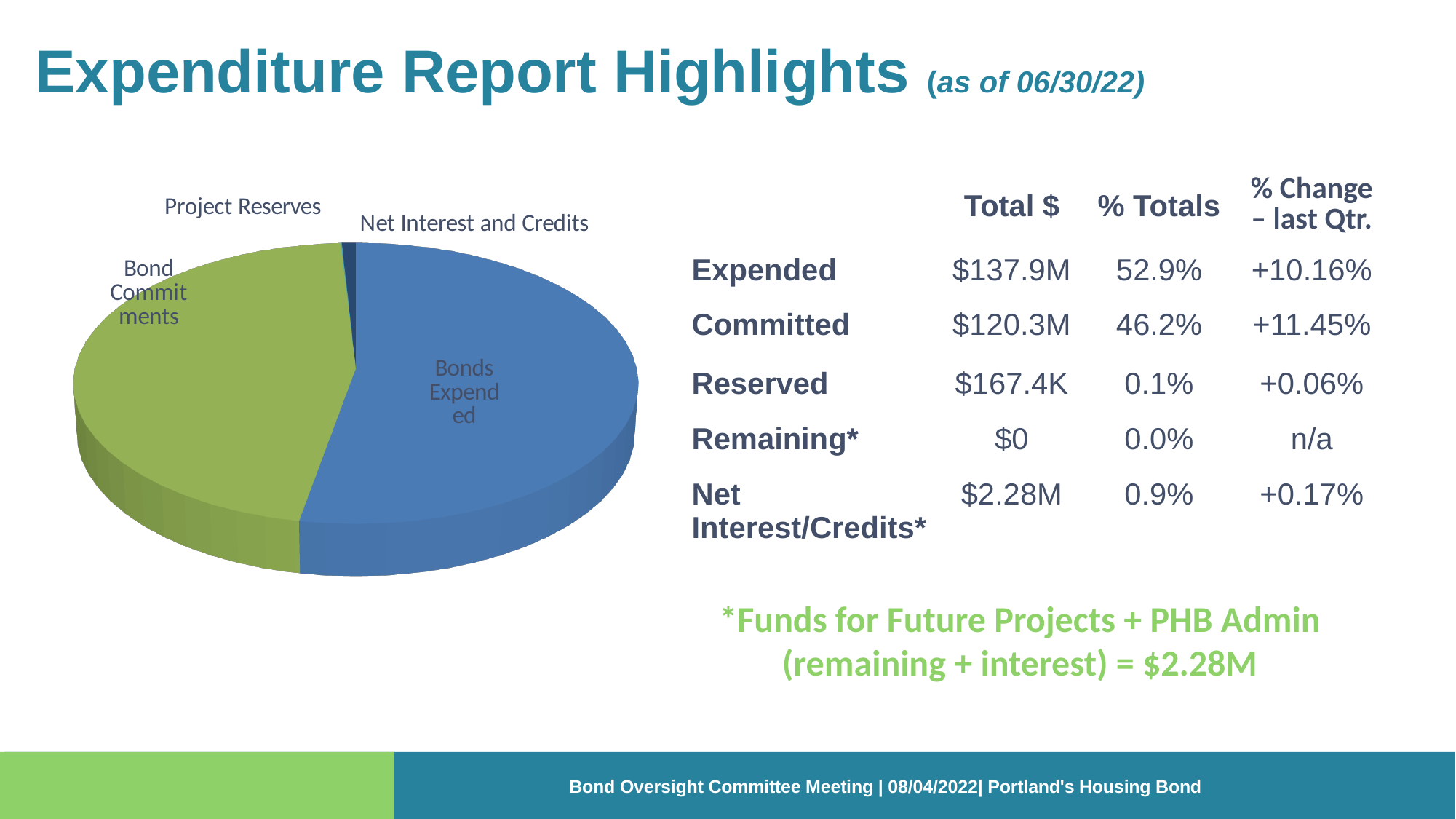
Which slice of the pie chart is the largest? Bonds Expended How many labelled slices does the pie chart have? 4 What colour is the Bonds Expended slice in the pie chart? Blue What type of chart is shown on the slide? Pie chart What colour is the Bond Commitments slice in the pie chart? Green Which is larger in the pie chart, Bond Commitments or Net Interest and Credits? Bond Commitments Which is larger in the pie chart, Net Interest and Credits or Bonds Expended? Bonds Expended Which is larger in the pie chart, Bonds Expended or Bond Commitments? Bonds Expended